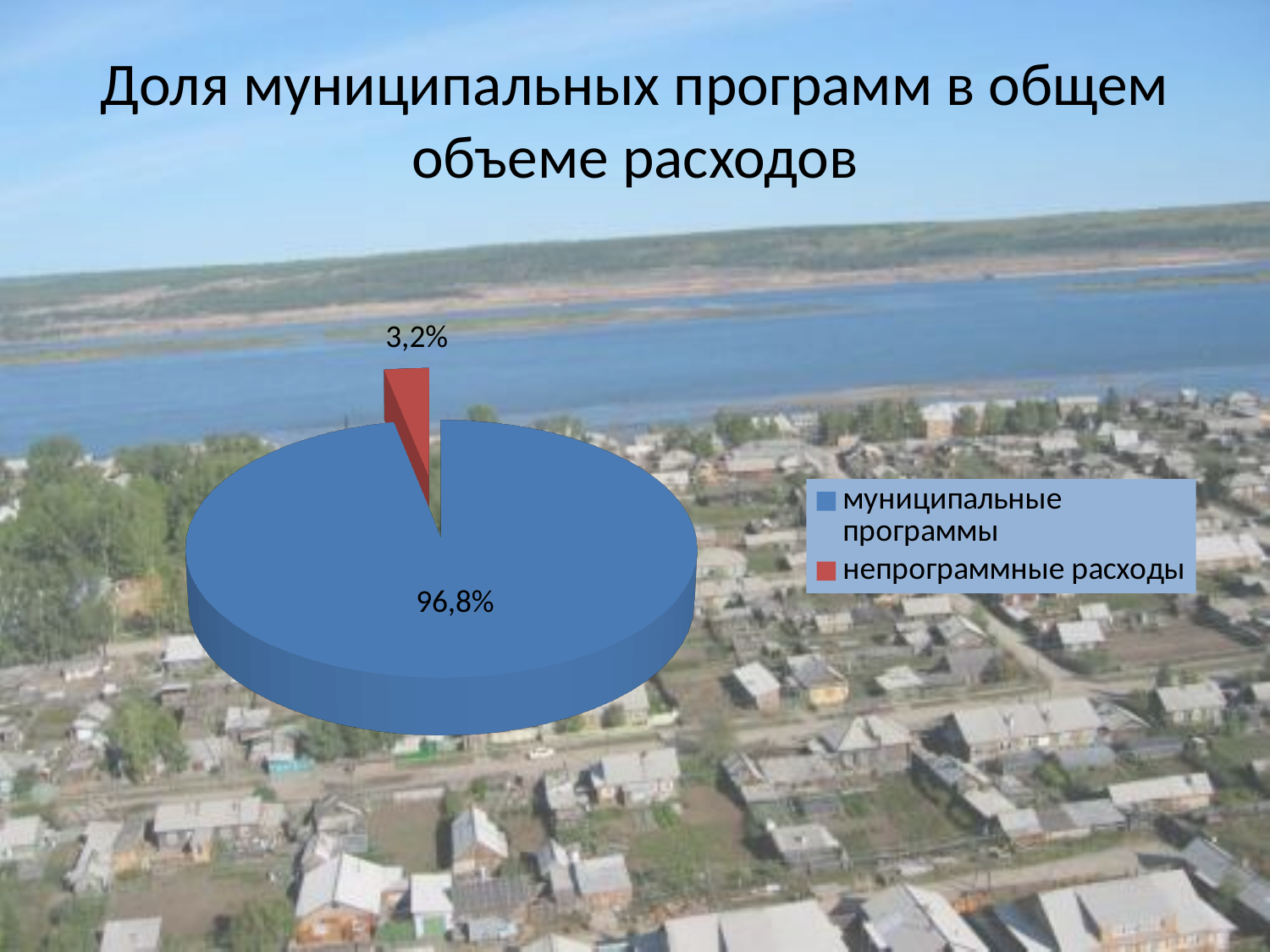
What kind of chart is shown on the slide? pie chart Which category has the largest slice of the pie? муниципальные программы How many slices does the pie chart have? 2 What share of the pie is labelled for непрограммные расходы? 3,2% What is the difference in percentage points between муниципальные программы and непрограммные расходы? 93,6 What share of the pie is labelled for муниципальные программы? 96,8% How many entries does the legend list? 2 Which category has the smallest slice of the pie? непрограммные расходы Which is larger: the slice for муниципальные программы or the slice for непрограммные расходы? муниципальные программы What is the title of the slide? Доля муниципальных программ в общем объеме расходов What colour is the slice for непрограммные расходы? red